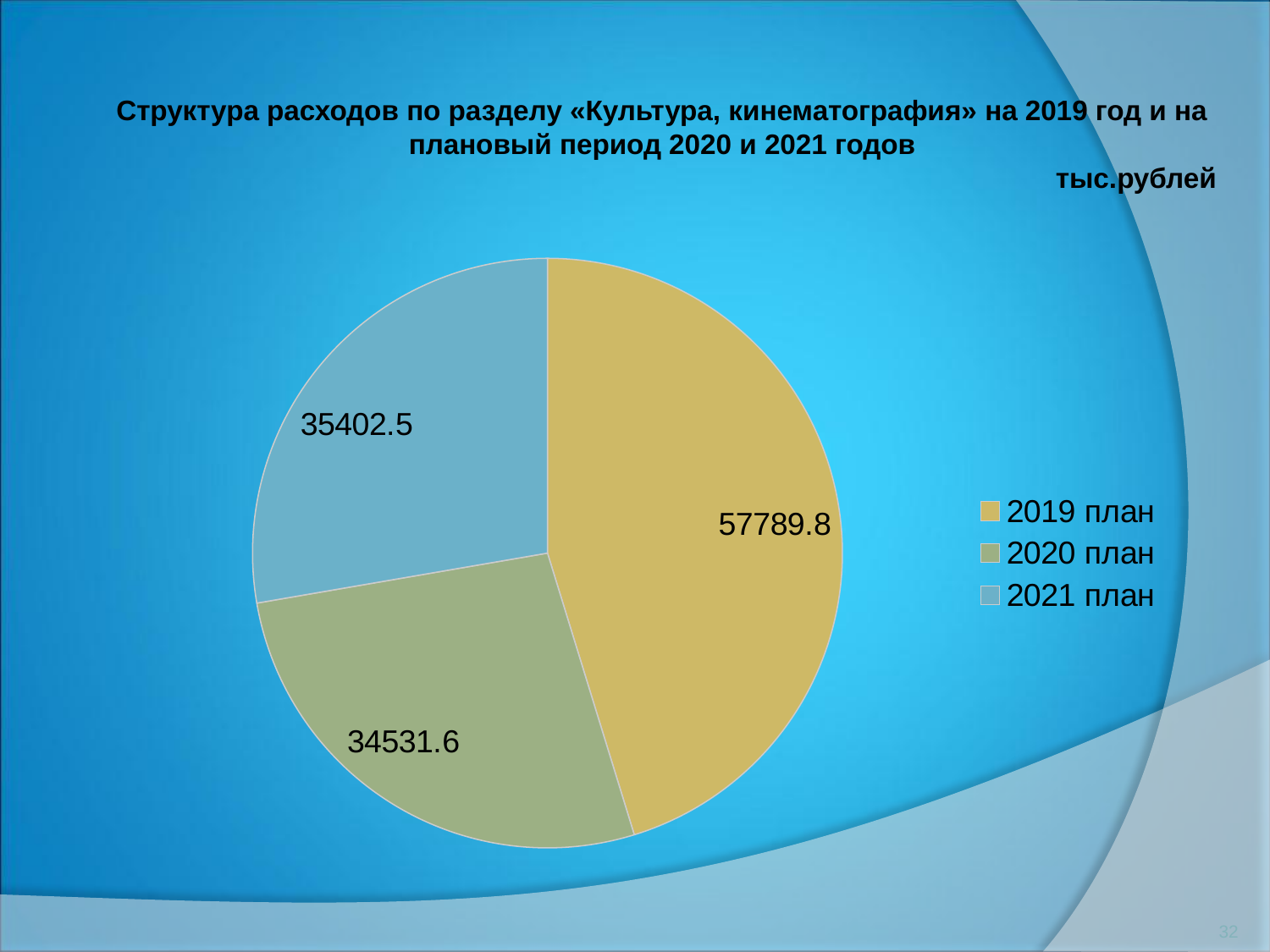
How many slices does the pie chart have? 3 Which category has the smallest value? 2020 план What is the value for 2019 план? 57789.8 Which category has the largest slice of the pie? 2019 план Which is larger, the value for 2020 план or 2021 план? 2021 план What is the value for 2020 план? 34531.6 What unit of measurement is indicated for the chart values? тыс.рублей What type of chart is shown on the slide? pie chart What is the value for 2021 план? 35402.5 What is the difference between the values for 2021 план and 2020 план? 870.9 What is the difference between the values for 2019 план and 2020 план? 23258.2